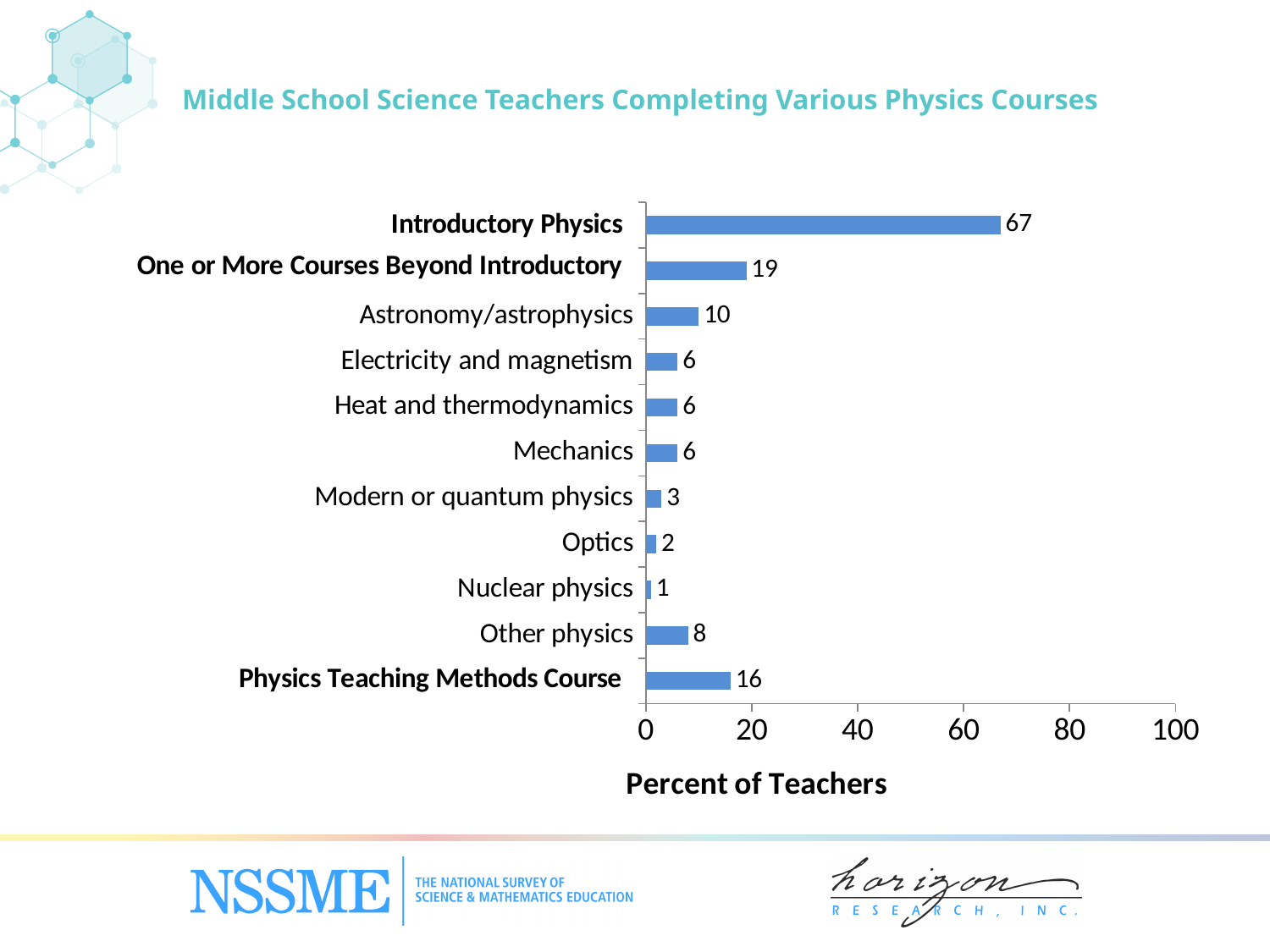
What is the label of the horizontal axis? Percent of Teachers What percent of teachers completed a Physics Teaching Methods Course? 16 What is the value for Nuclear physics? 1 Which category has the highest value? Introductory Physics What percent of teachers completed Introductory Physics? 67 Which is larger, the value for Other physics or the value for Optics? Other physics What is the value for Astronomy/astrophysics? 10 What kind of chart is shown on the slide? Bar chart How many categories are shown in the chart? 11 What is the difference between the values for Introductory Physics and One or More Courses Beyond Introductory? 48 Is the value for One or More Courses Beyond Introductory greater or less than 40? less Which category has the lowest value? Nuclear physics